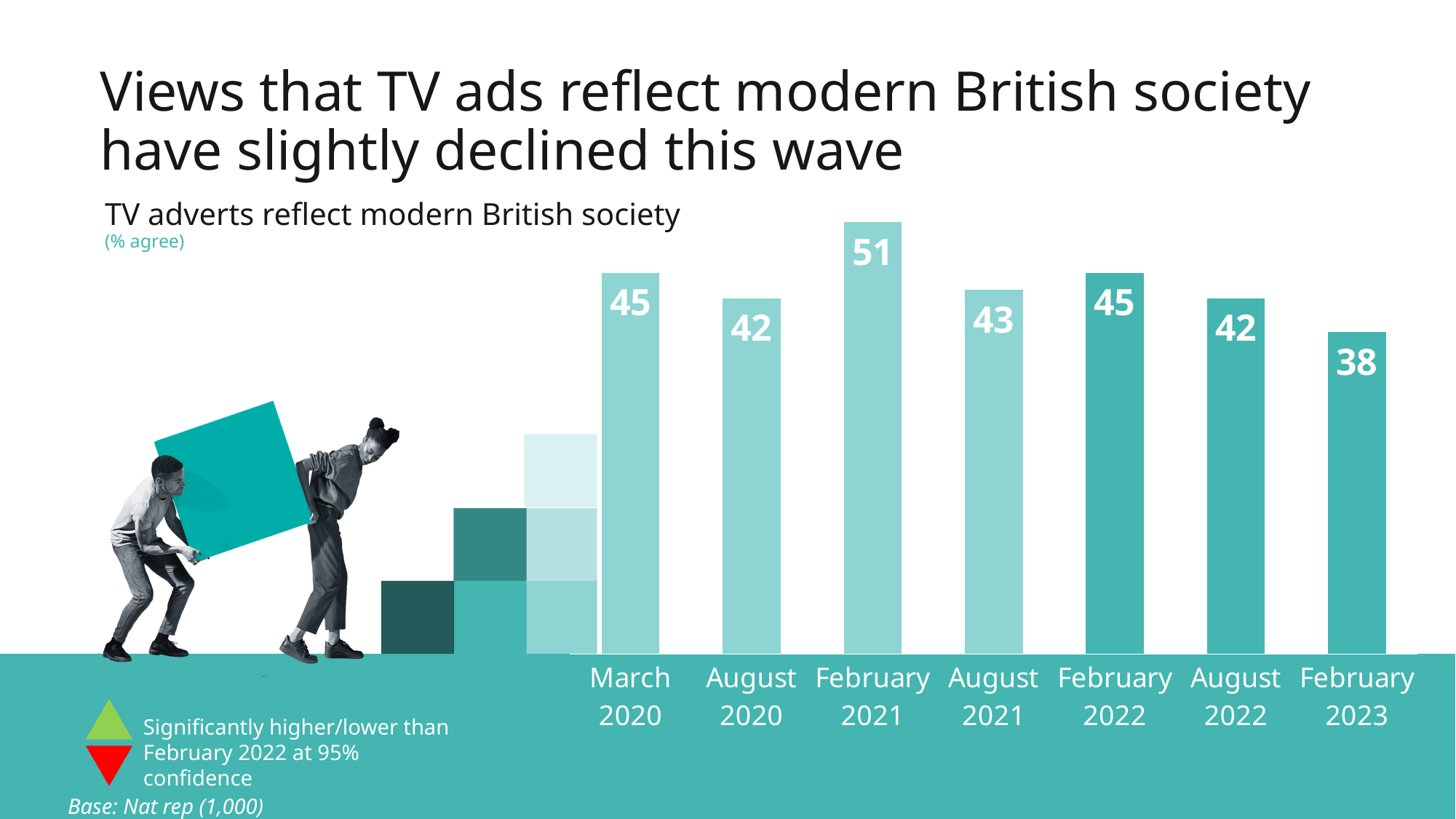
How many periods are shown on the chart? 7 What is the value for August 2021? 43 Which period has the lowest value? February 2023 What is the difference between the values for February 2022 and February 2023? 7 What is the difference between the values for February 2021 and February 2023? 13 Which is larger, the value for August 2020 or the value for August 2021? August 2021 What is the value for February 2021? 51 What is the value for February 2023? 38 What kind of chart is shown on the slide? Bar chart What is the chart's title? TV adverts reflect modern British society Which period has the highest value? February 2021 What is the value for March 2020? 45